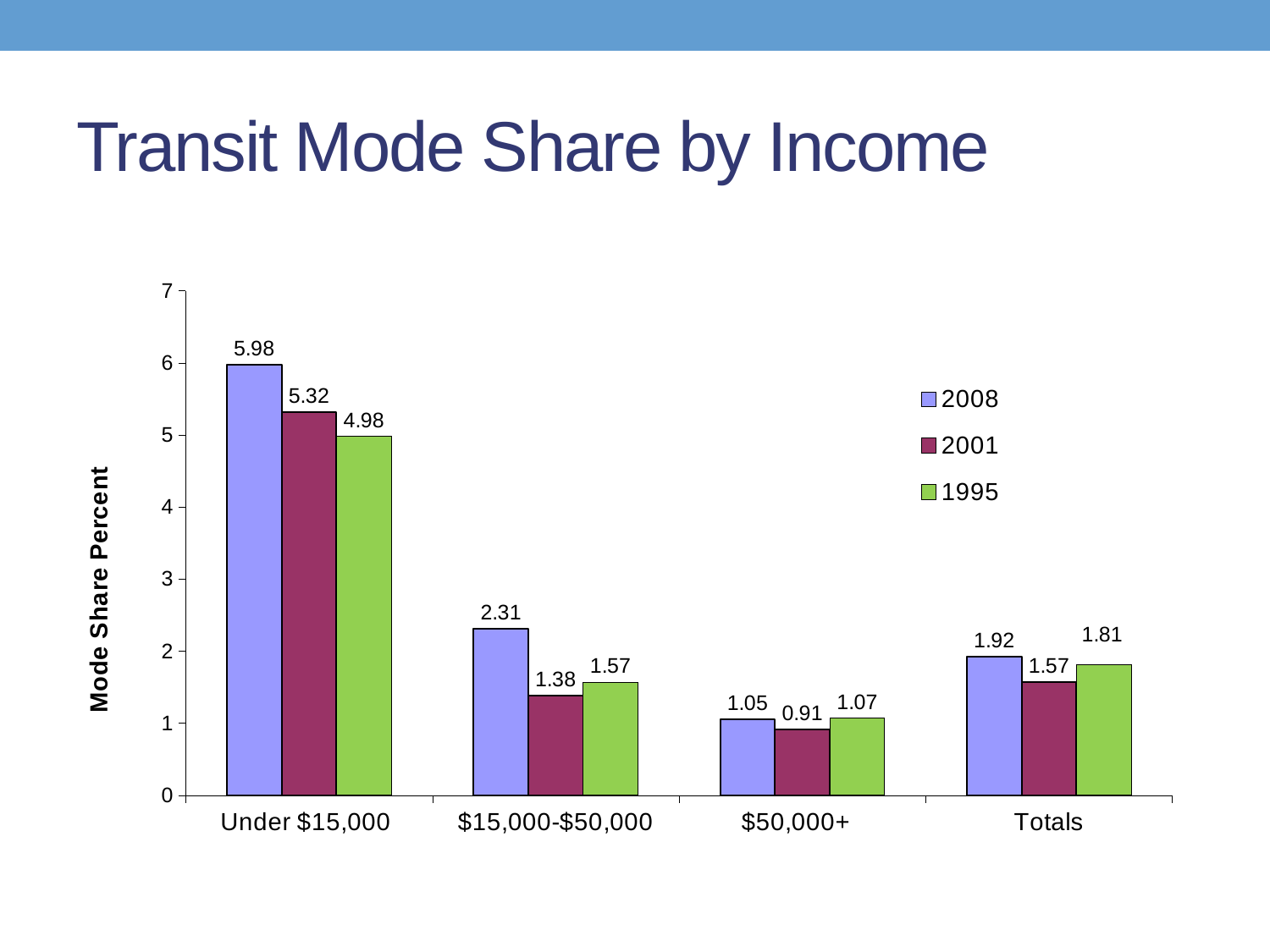
How many series does the legend list? 3 What is the difference between the 2008 and 1995 values for the Under $15,000 group? 1.00 Which income group has the highest 2008 transit mode share? Under $15,000 What is the 2001 value for the $50,000+ income group? 0.91 What is the 1995 value for the $15,000-$50,000 income group? 1.57 How many income categories are shown on the x axis? 4 For the Totals category, which is larger: the 2001 value or the 1995 value? 1995 What is the 2008 transit mode share percent for the Under $15,000 income group? 5.98 What is the difference between the 2008 and 2001 values for the $15,000-$50,000 group? 0.93 What is the label of the y axis? Mode Share Percent What kind of chart is shown on the slide? Bar chart Which income group has the lowest 1995 transit mode share? $50,000+